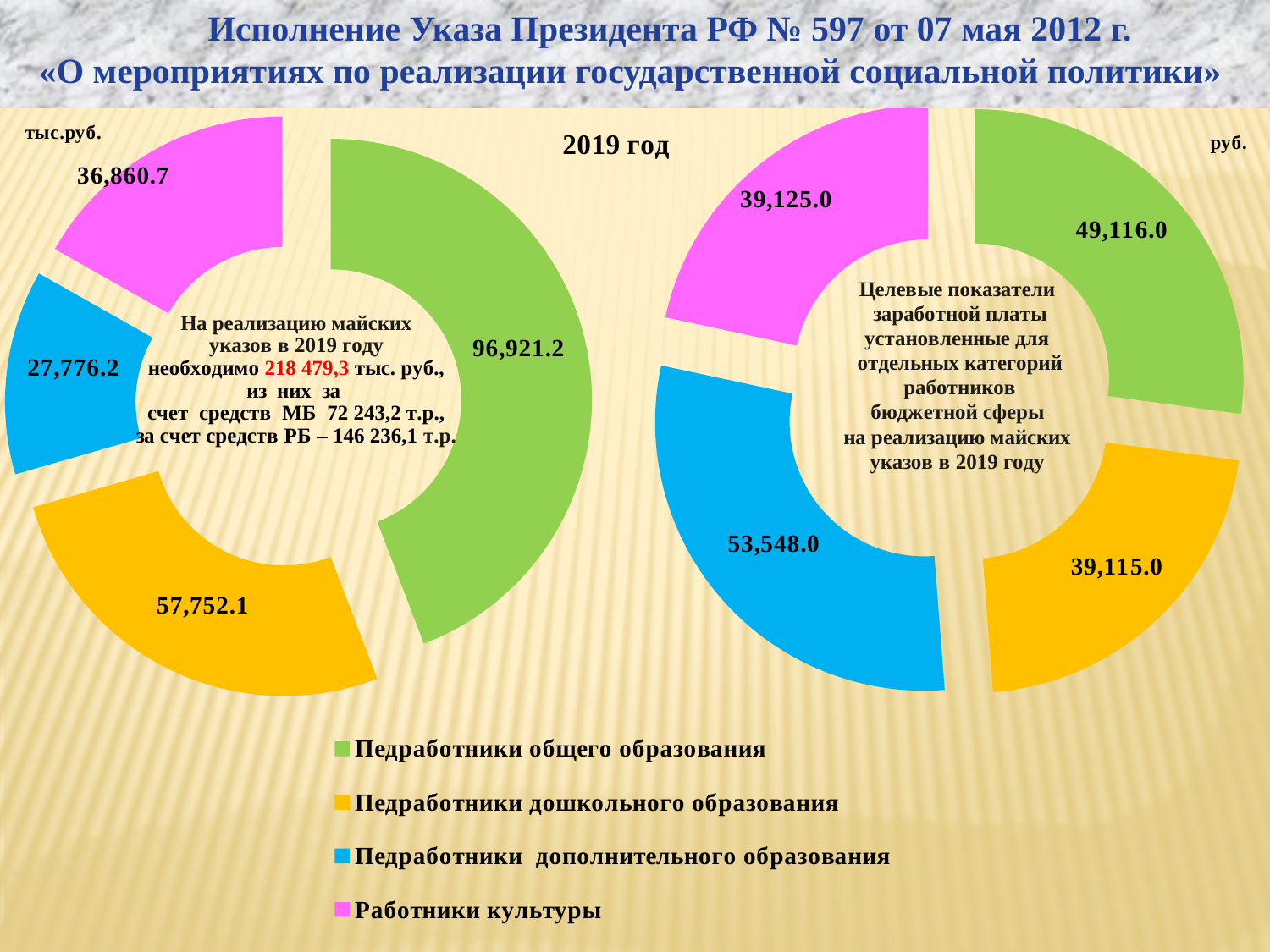
On the left chart, what is the difference between the values for Педработники общего образования and Педработники дошкольного образования? 39,169.1 On the right chart, what is the value for Педработники дошкольного образования? 39,115.0 How many categories does the legend list? 4 On the right chart, what is the difference between the values for Педработники дополнительного образования and Педработники общего образования? 4,432.0 On the left chart, which category has the largest value? Педработники общего образования On the left chart, which is larger: the value for Работники культуры or the value for Педработники дополнительного образования? Работники культуры On the left chart, what is the value for Работники культуры? 36,860.7 On the left chart, which category has the smallest value? Педработники дополнительного образования On the left chart, what is the value for Педработники общего образования? 96,921.2 What kind of chart is the left chart? Doughnut (pie) chart On the right chart, what is the value for Педработники дополнительного образования? 53,548.0 On the right chart, which category has the largest value? Педработники дополнительного образования